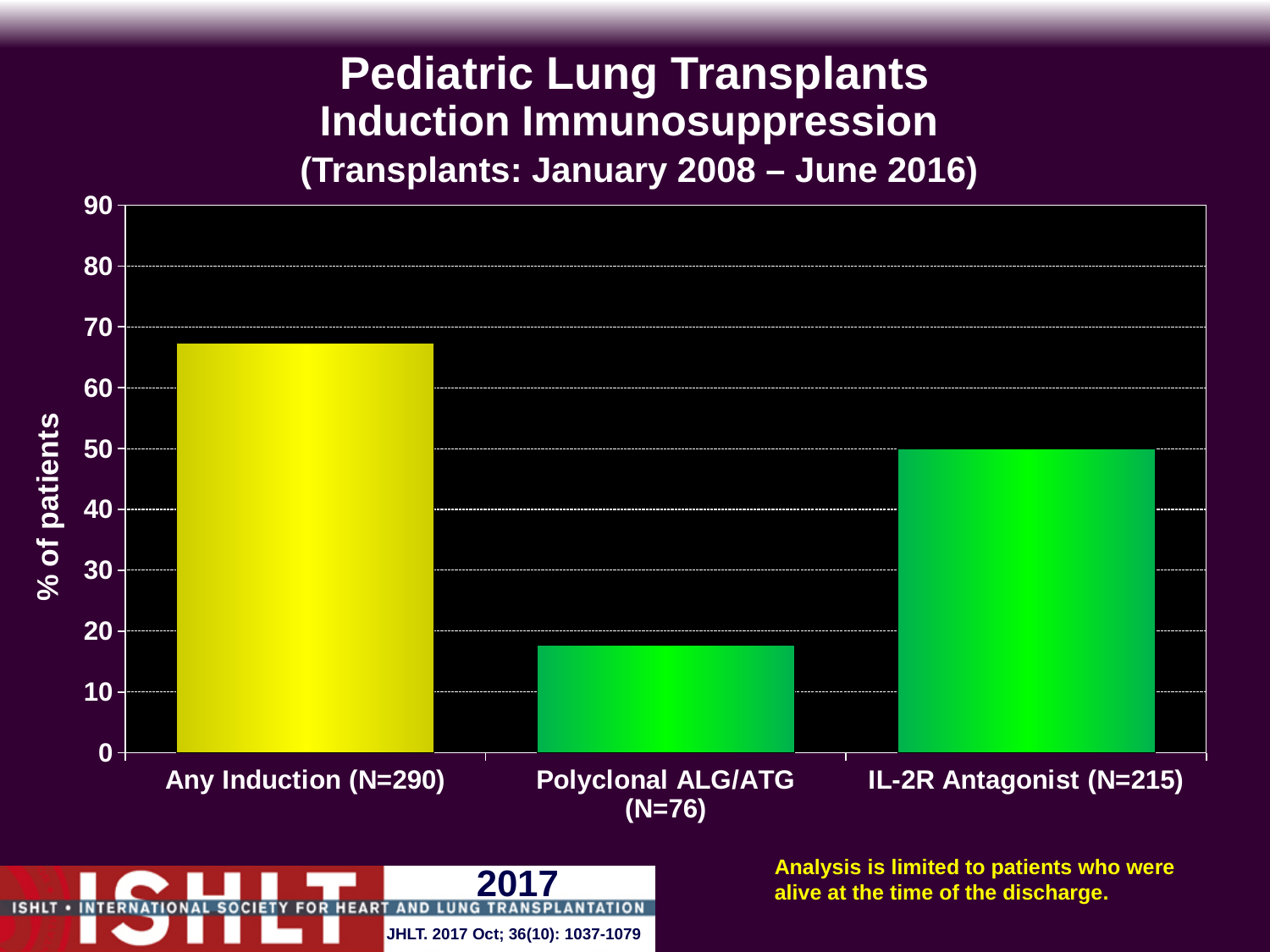
What is the label of the y axis? % of patients Which category has the lowest percentage of patients? Polyclonal ALG/ATG (N=76) What kind of chart is shown on the slide? bar chart Is the value for Any Induction (N=290) greater or less than 60? greater Which is larger, the value for Any Induction (N=290) or the value for IL-2R Antagonist (N=215)? Any Induction (N=290) What time period of transplants does the chart title say it covers? January 2008 – June 2016 Is the value for Polyclonal ALG/ATG (N=76) greater or less than 20? less How many categories are plotted on the chart? 3 Is the value for IL-2R Antagonist (N=215) greater or less than 40? greater Which is larger, the value for Polyclonal ALG/ATG (N=76) or the value for IL-2R Antagonist (N=215)? IL-2R Antagonist (N=215) Which category has the highest percentage of patients? Any Induction (N=290)